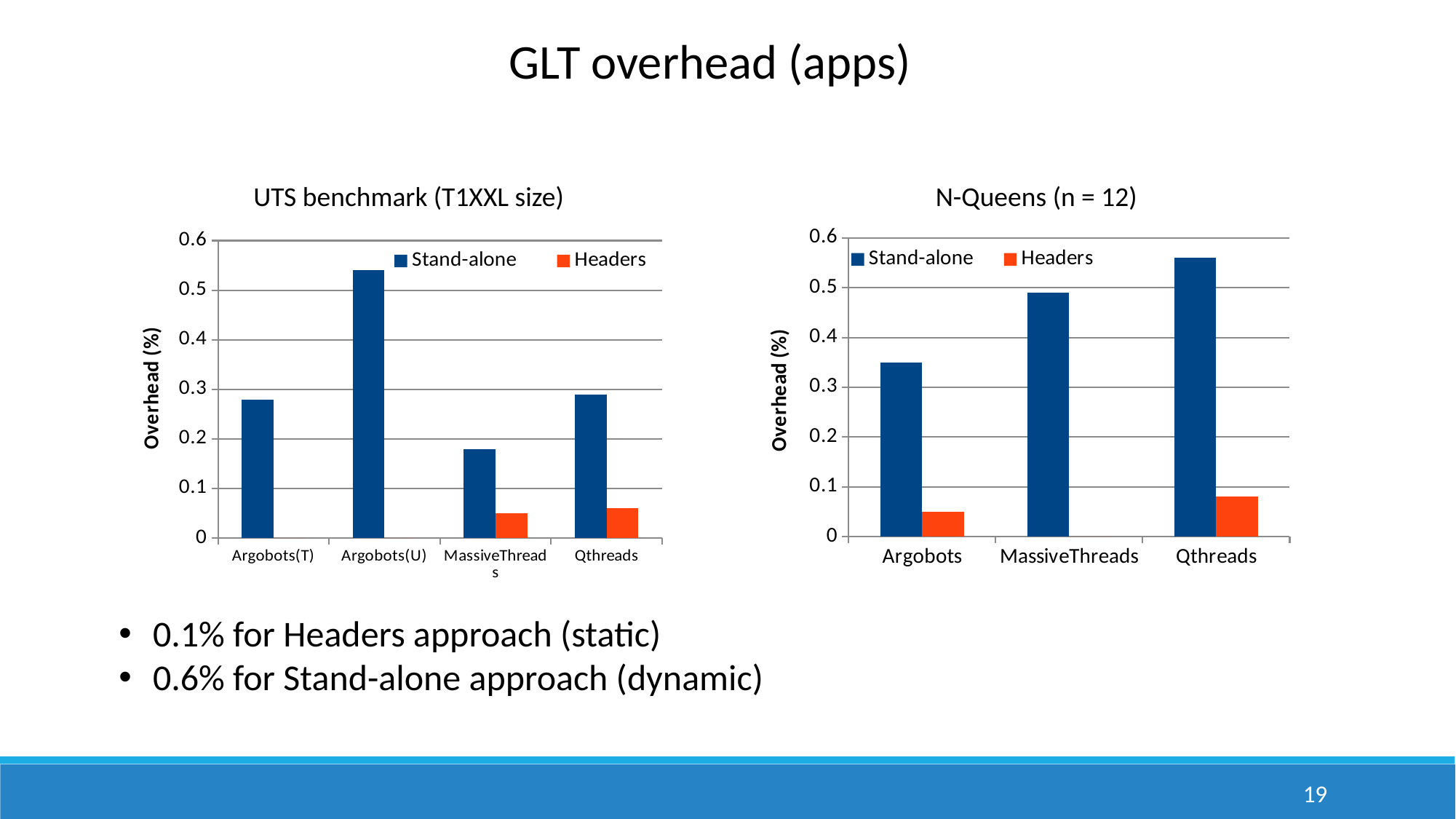
In the N-Queens (n = 12) chart, is the Stand-alone value for Argobots greater or less than 0.4? less In the UTS benchmark (T1XXL size) chart, how many categories are shown on the x axis? 4 In the UTS benchmark (T1XXL size) chart, which category has the lowest Stand-alone overhead? MassiveThreads What is the y-axis label of the N-Queens (n = 12) chart? Overhead (%) In the UTS benchmark (T1XXL size) chart, which category has the highest Stand-alone overhead? Argobots(U) In the N-Queens (n = 12) chart, which is larger, the Stand-alone value for Argobots or for MassiveThreads? MassiveThreads In the UTS benchmark (T1XXL size) chart, is the Stand-alone value for MassiveThreads greater or less than 0.2? less In the UTS benchmark (T1XXL size) chart, is the Stand-alone value for Argobots(U) greater or less than 0.5? greater In the UTS benchmark (T1XXL size) chart, how many series does the legend list? 2 What type of chart is the UTS benchmark (T1XXL size) chart? bar chart In the N-Queens (n = 12) chart, which category has the highest Stand-alone overhead? Qthreads In the N-Queens (n = 12) chart, how many categories are shown on the x axis? 3